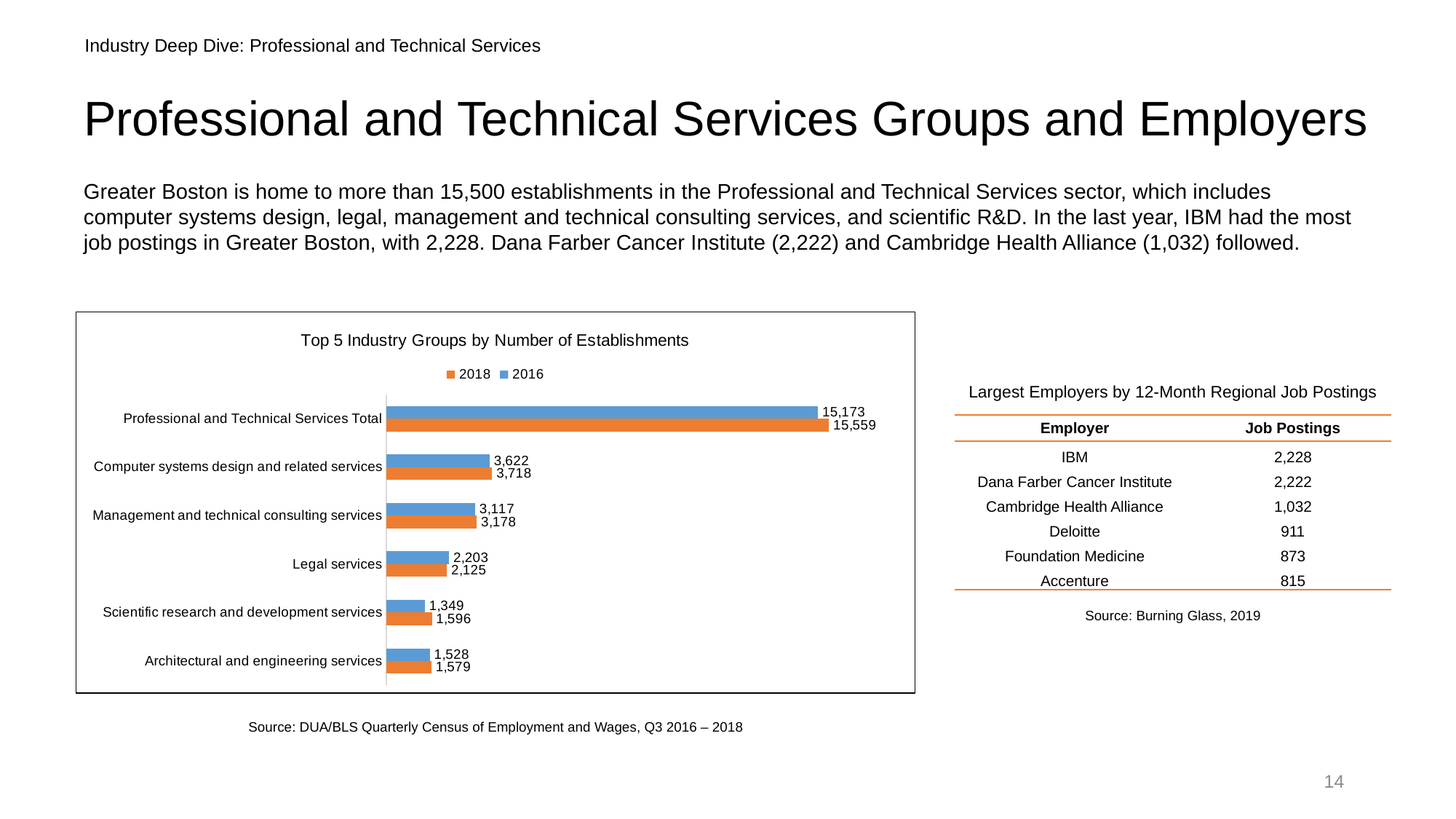
What type of chart is "Top 5 Industry Groups by Number of Establishments"? Bar chart What is the 2018 value for Scientific research and development services? 1,596 Which colour represents the 2018 series in the "Top 5 Industry Groups by Number of Establishments" chart? Orange What is the 2016 value for Professional and Technical Services Total? 15,173 What is the 2018 value for Computer systems design and related services? 3,718 How many series does the legend of the "Top 5 Industry Groups by Number of Establishments" chart list? 2 For Legal services, which is larger: the 2016 value or the 2018 value? 2016 Excluding the Total, which industry group has the highest 2018 value? Computer systems design and related services How many categories are shown on the "Top 5 Industry Groups by Number of Establishments" chart? 6 Which industry group has the lowest 2016 value? Scientific research and development services What is the difference between the 2018 and 2016 values for Professional and Technical Services Total? 386 What is the 2016 value for Legal services? 2,203